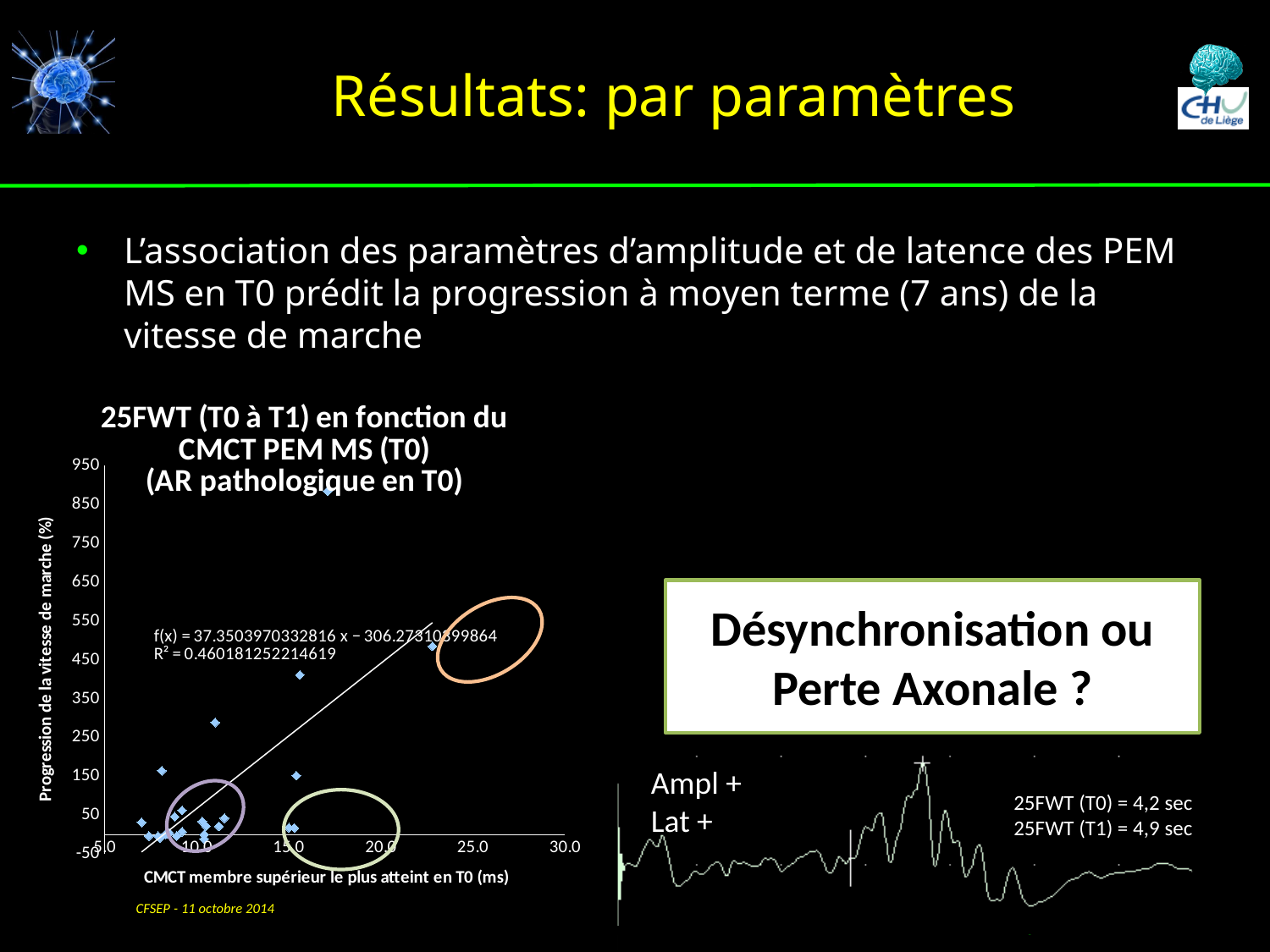
What is the title of the chart on the left of the slide? 25FWT (T0 à T1) en fonction du CMCT PEM MS (T0) (AR pathologique en T0) What is the highest tick value shown on the horizontal axis of the scatter chart? 30.0 Does the trendline on the scatter chart rise or fall as CMCT increases along the x axis? rise Is the highest point on the scatter chart greater or less than 850 on the vertical axis? greater What is the slope coefficient of x in the trendline equation printed on the scatter chart? 37.3503970332816 What R² value is printed on the scatter chart? 0.460181252214619 Is the point circled in orange on the scatter chart (near 23 ms) greater or less than 350 on the vertical axis? greater What is the label of the vertical axis of the scatter chart? Progression de la vitesse de marche (%) What kind of chart is shown on the left of the slide? scatter chart What is the highest tick value shown on the vertical axis of the scatter chart? 950 Are the points circled in green on the scatter chart (between 15 and 20 ms) greater or less than 150 on the vertical axis? less